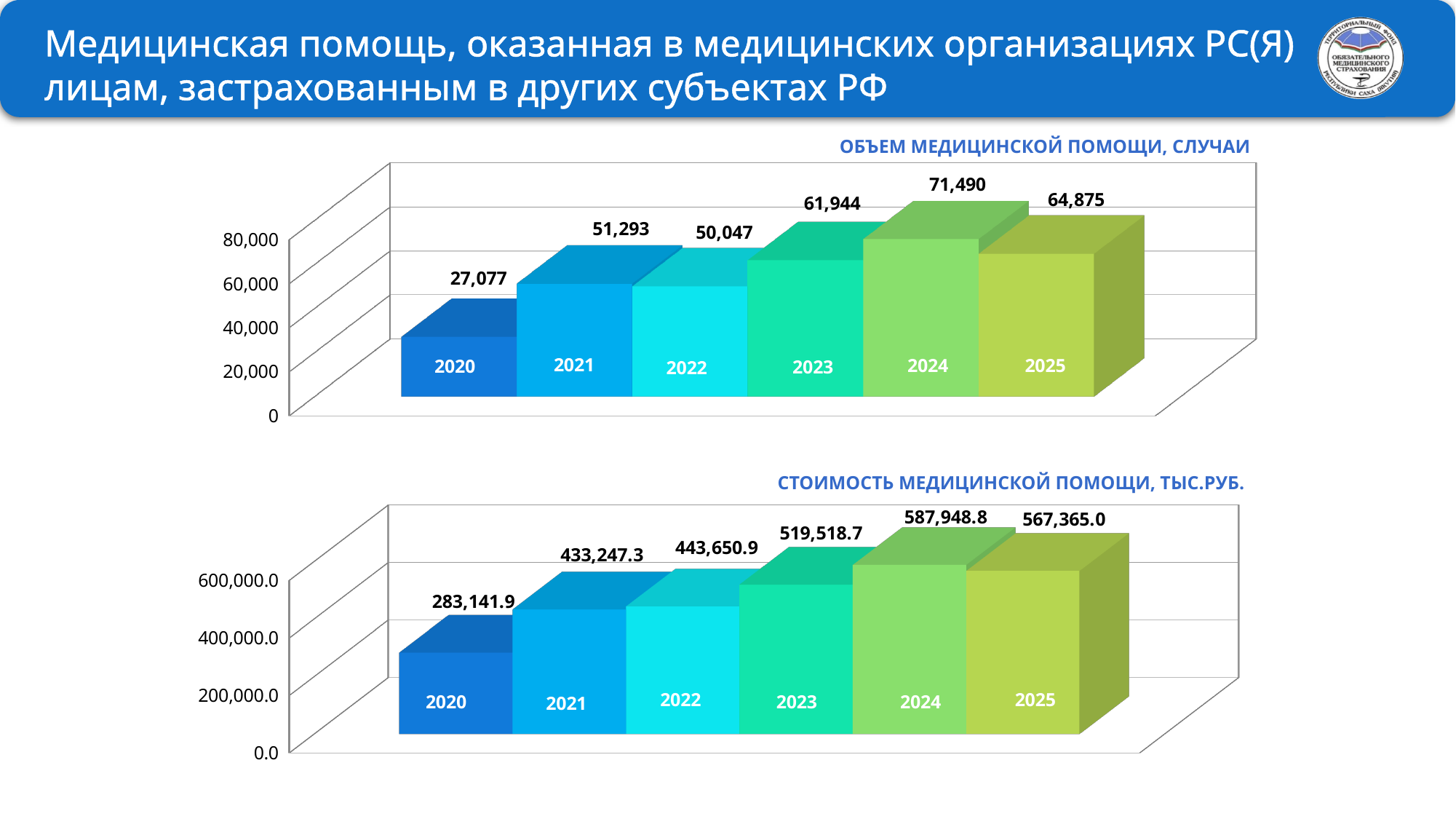
In the top chart (ОБЪЕМ МЕДИЦИНСКОЙ ПОМОЩИ, СЛУЧАИ), which year has the lowest value? 2020 In the bottom chart (СТОИМОСТЬ МЕДИЦИНСКОЙ ПОМОЩИ, ТЫС.РУБ.), what is the value for 2023? 519,518.7 In the top chart (ОБЪЕМ МЕДИЦИНСКОЙ ПОМОЩИ, СЛУЧАИ), how many years are shown? 6 In the top chart (ОБЪЕМ МЕДИЦИНСКОЙ ПОМОЩИ, СЛУЧАИ), which year has the highest value? 2024 In the bottom chart (СТОИМОСТЬ МЕДИЦИНСКОЙ ПОМОЩИ, ТЫС.РУБ.), is the value for 2020 greater or less than 400,000.0? less What kind of chart is the top chart (ОБЪЕМ МЕДИЦИНСКОЙ ПОМОЩИ, СЛУЧАИ)? bar chart In the top chart (ОБЪЕМ МЕДИЦИНСКОЙ ПОМОЩИ, СЛУЧАИ), what is the difference between the values for 2024 and 2025? 6,615 In the top chart (ОБЪЕМ МЕДИЦИНСКОЙ ПОМОЩИ, СЛУЧАИ), does the value rise or fall from 2020 to 2021? rise In the bottom chart (СТОИМОСТЬ МЕДИЦИНСКОЙ ПОМОЩИ, ТЫС.РУБ.), which is larger, the value for 2021 or 2022? 2022 In the bottom chart (СТОИМОСТЬ МЕДИЦИНСКОЙ ПОМОЩИ, ТЫС.РУБ.), what is the difference between the values for 2024 and 2020? 304,806.9 In the top chart (ОБЪЕМ МЕДИЦИНСКОЙ ПОМОЩИ, СЛУЧАИ), what is the value for 2020? 27,077 In the bottom chart (СТОИМОСТЬ МЕДИЦИНСКОЙ ПОМОЩИ, ТЫС.РУБ.), which year has the highest value? 2024